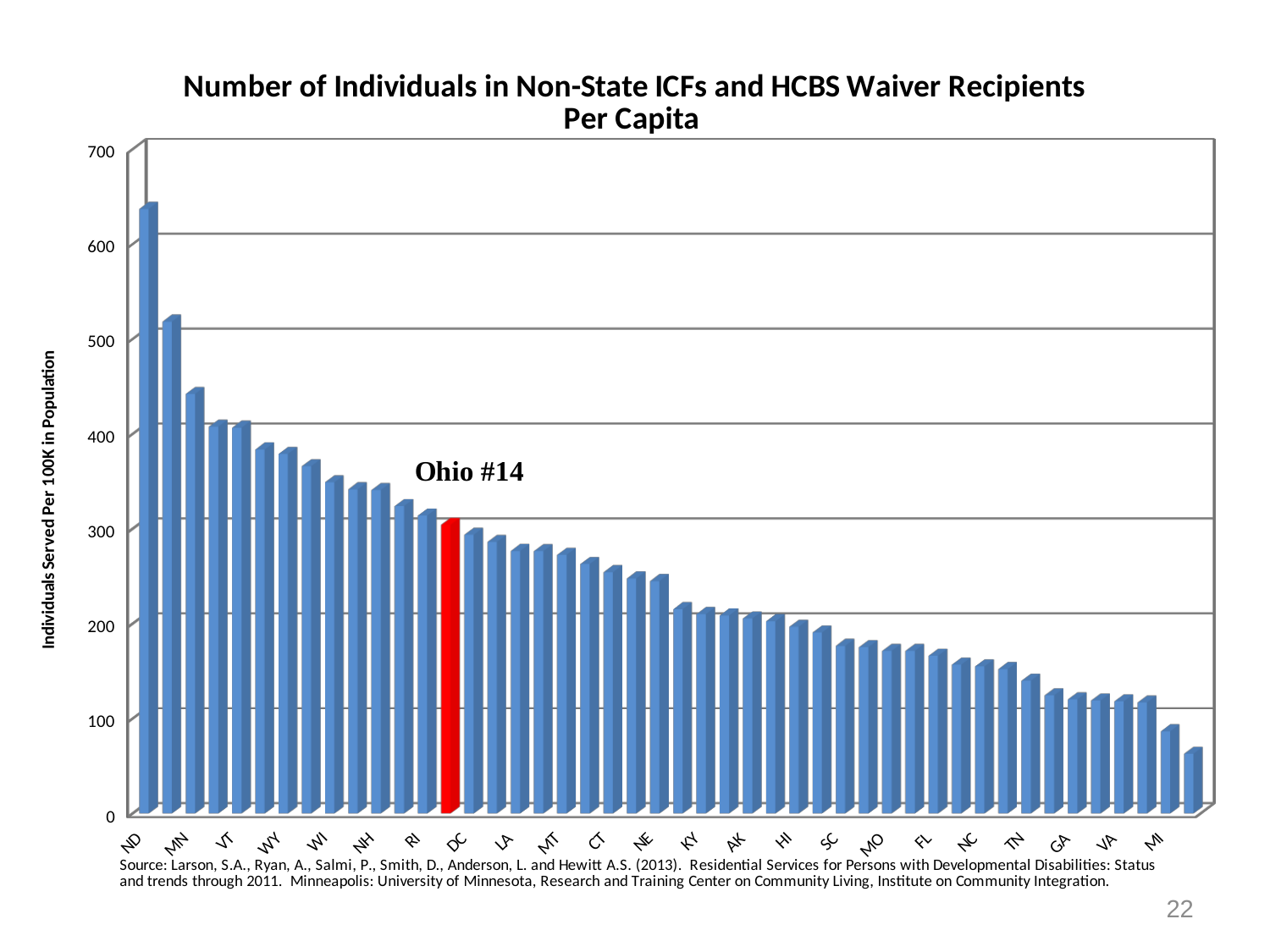
Which state has the highest value in the chart? ND Is the value for MI greater or less than 100? less Is the value for ND greater or less than 600? greater What rank is Ohio shown as in the chart? #14 Is the value for KY greater or less than 200? greater What kind of chart is shown on the slide? bar chart Which has a larger value, ND or MN? ND What is the label on the vertical axis? Individuals Served Per 100K in Population Do the values rise or fall moving from left to right along the x axis? fall